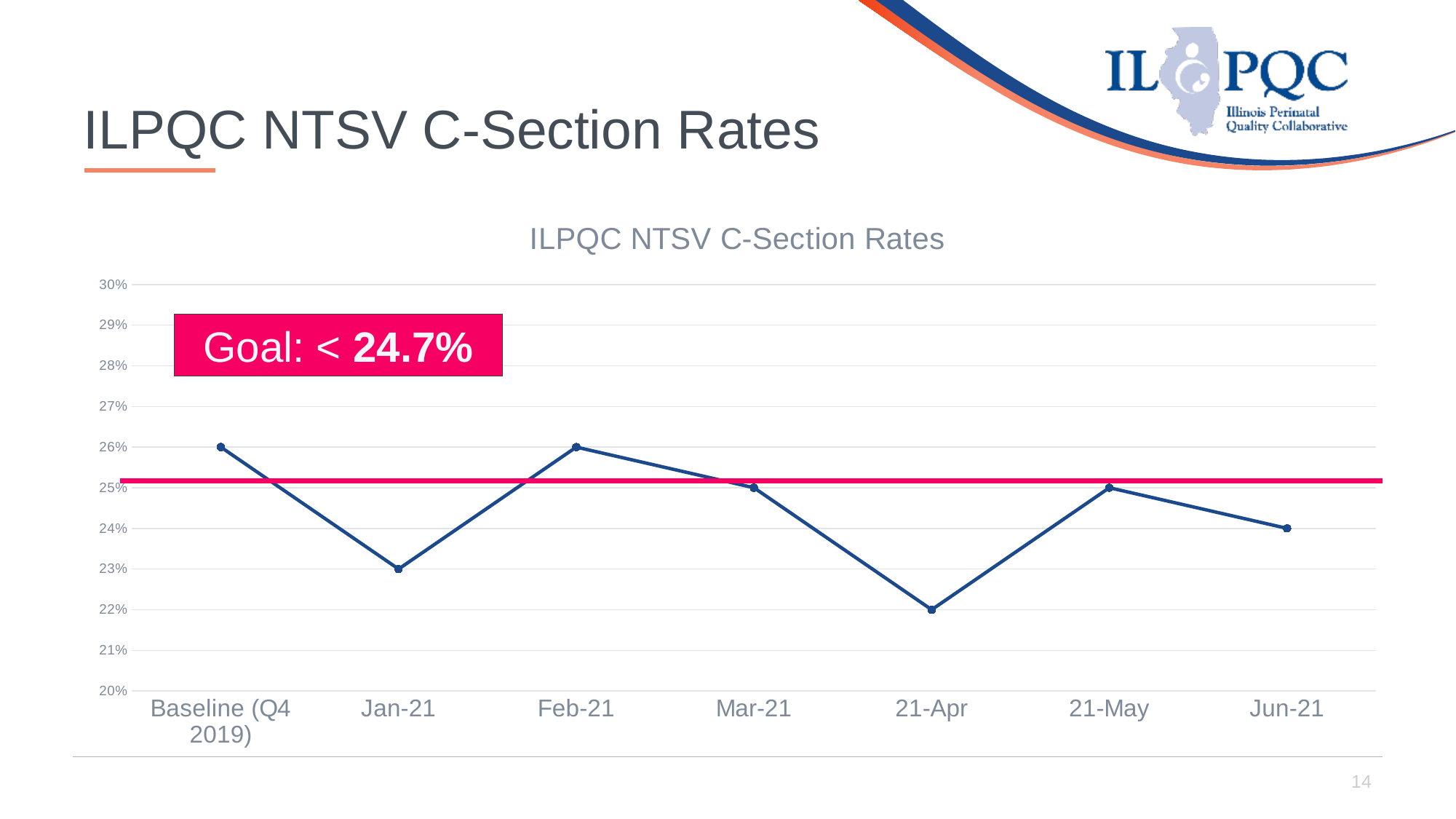
Does the rate rise or fall from 21-May to Jun-21? fall What is the NTSV C-section rate for Jun-21? 24% What is the NTSV C-section rate for 21-Apr? 22% How many data points are plotted on the line? 7 Which period has the lowest NTSV C-section rate? 21-Apr What is the NTSV C-section rate for Jan-21? 23% What goal value is shown in the pink box on the chart? < 24.7% Is the value for 21-May greater or less than 24%? greater Which is larger, the rate for Mar-21 or the rate for Jun-21? Mar-21 What type of chart is shown on the slide? line chart What is the difference between the Feb-21 rate and the Jan-21 rate? 3% What is the title of the chart? ILPQC NTSV C-Section Rates